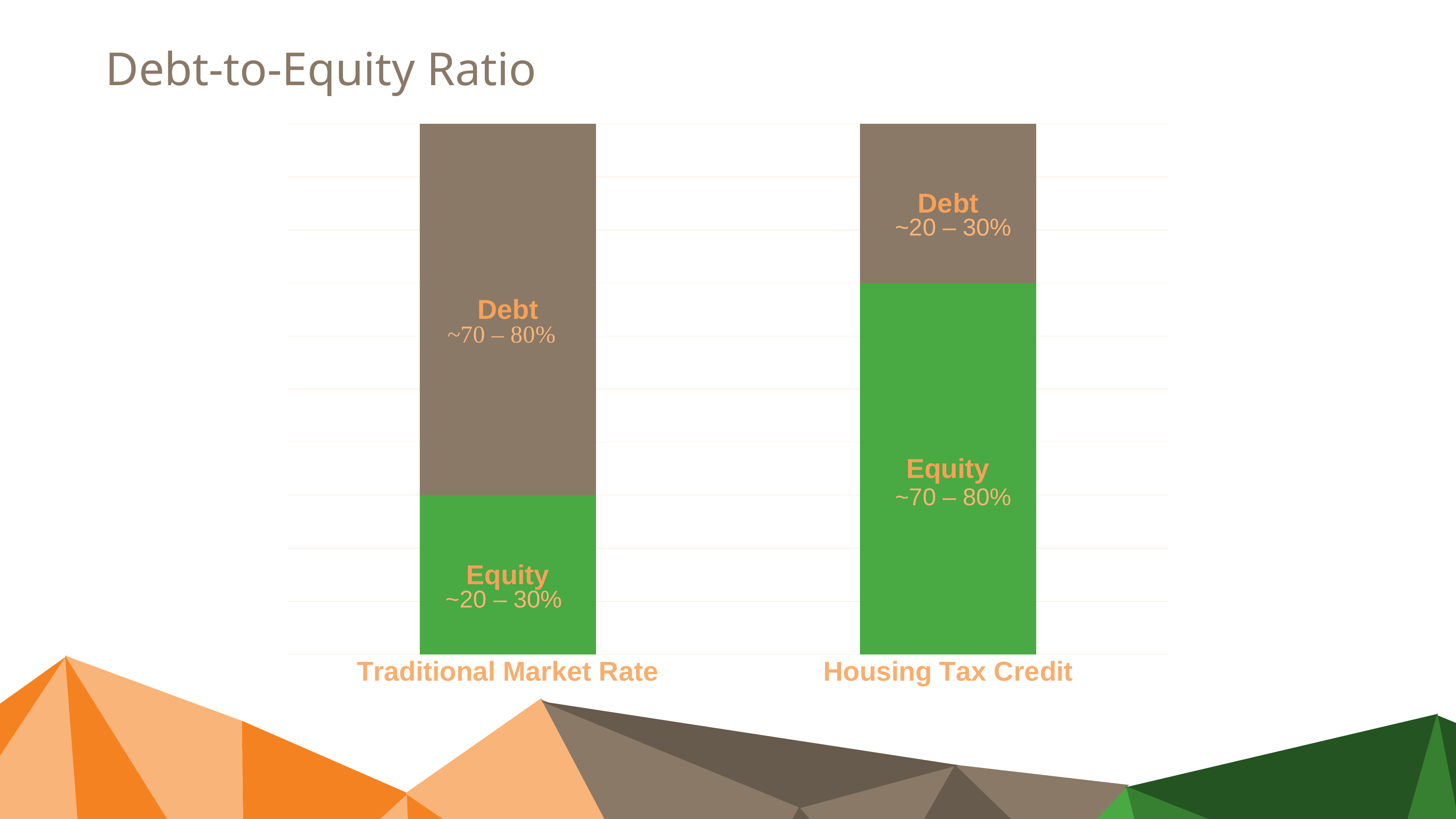
How many categories are shown on the x axis? 2 What colour are the Equity segments in the chart? Green Which category has the smaller Equity segment? Traditional Market Rate What is the Debt label printed for Housing Tax Credit? ~20 – 30% What is the Equity label printed for Housing Tax Credit? ~70 – 80% For Traditional Market Rate, which segment is larger, Debt or Equity? Debt What is the Equity label printed for Traditional Market Rate? ~20 – 30% What is the Debt label printed for Traditional Market Rate? ~70 – 80% What is the chart's title? Debt-to-Equity Ratio What kind of chart is shown on the slide? Stacked bar chart Which category has the larger Debt segment? Traditional Market Rate For Housing Tax Credit, which segment is larger, Debt or Equity? Equity